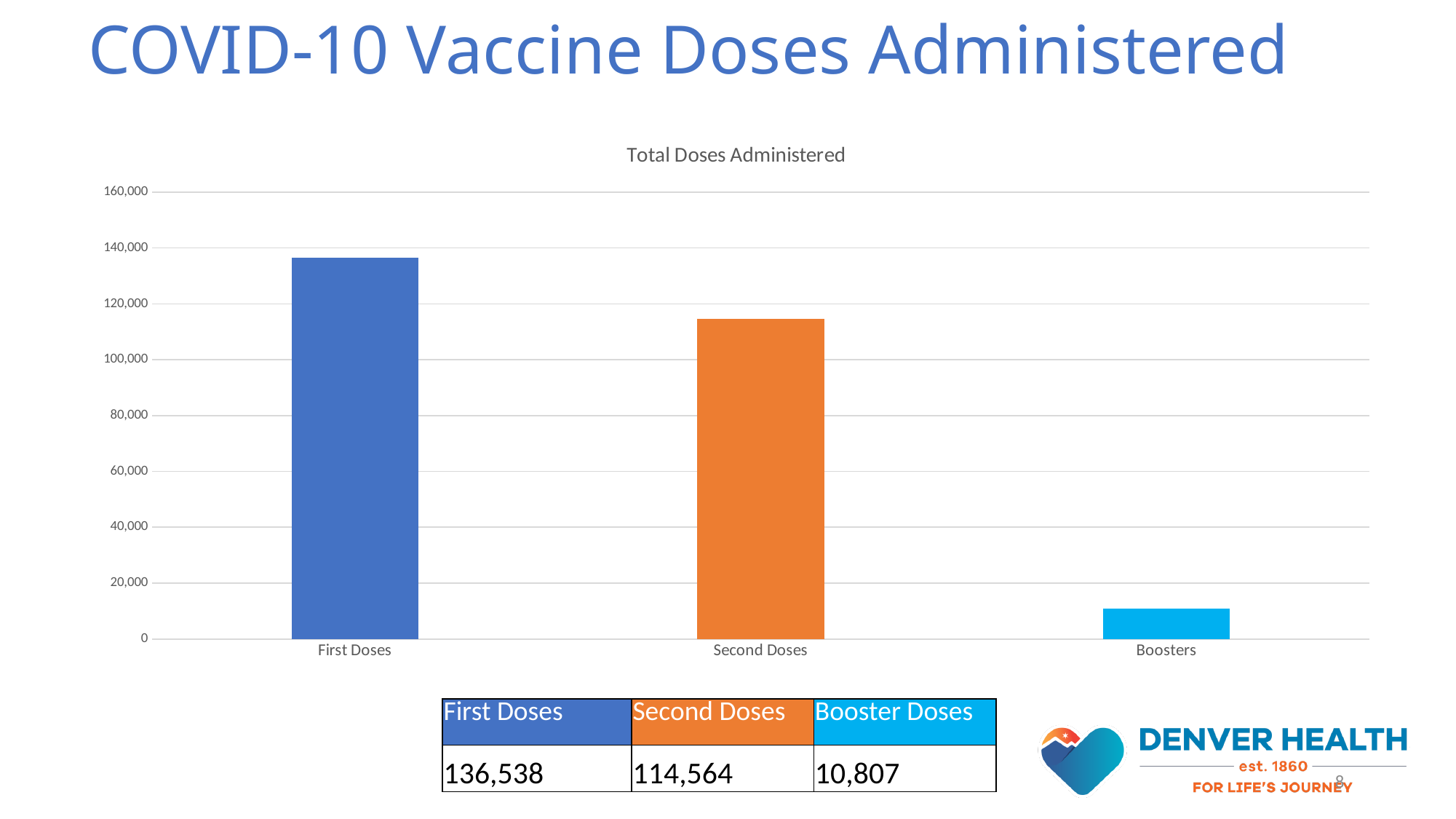
Which category has the highest number of doses administered? First Doses Is the value for Second Doses greater or less than 100,000? greater How many doses are shown for Second Doses? 114,564 How many doses are shown for First Doses? 136,538 What is the difference between First Doses and Second Doses? 21,974 Which is larger, Second Doses or Boosters? Second Doses How many categories are plotted in the chart? 3 Which category has the lowest number of doses administered? Boosters How many doses are shown for Boosters? 10,807 What type of chart is shown on the slide? Bar chart Do the values rise or fall from left to right across the categories? Fall What is the title of the chart? Total Doses Administered